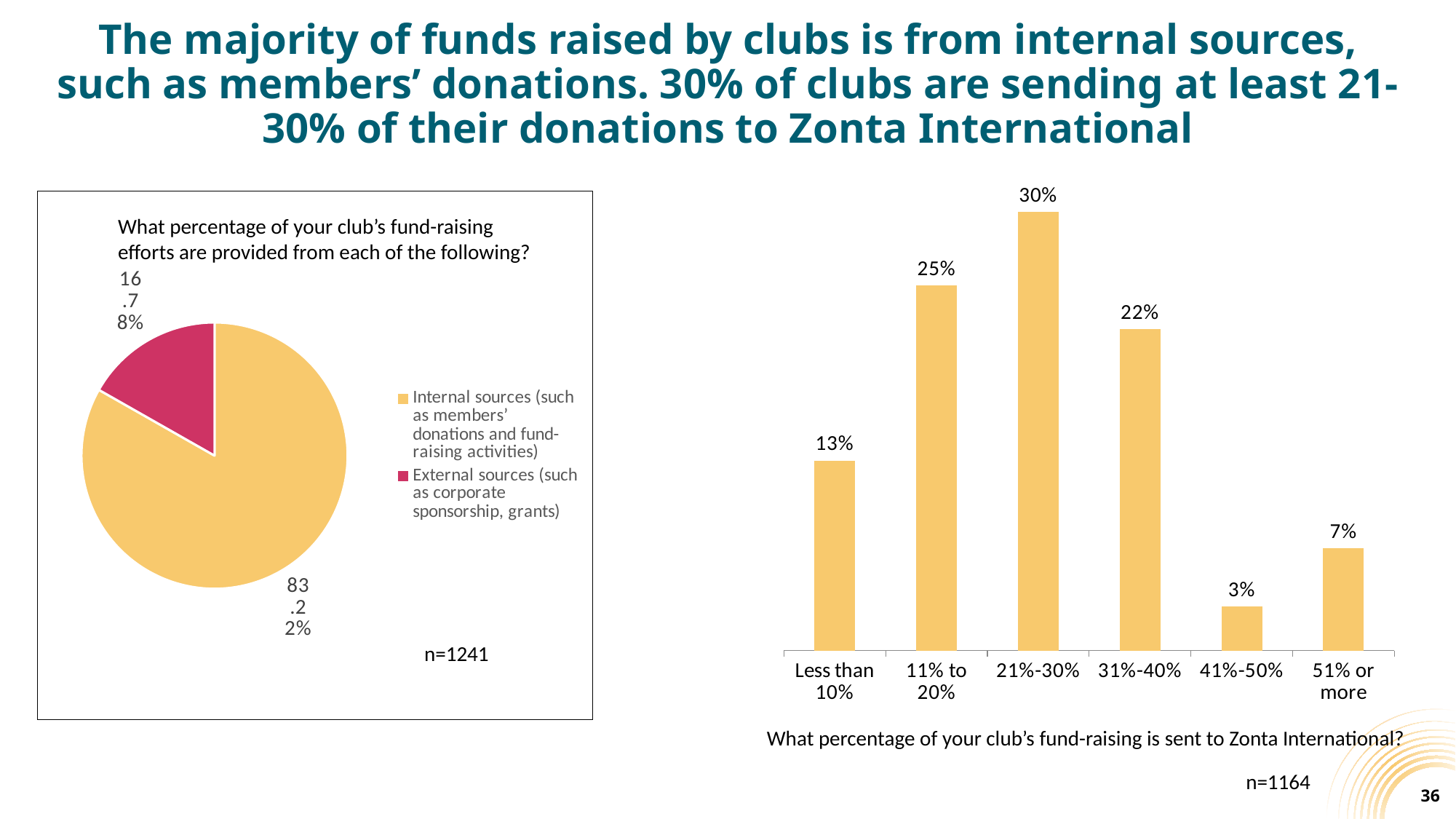
How many entries does the legend of the pie chart on the left list? 2 On the bar chart on the right, what is the difference between the values for '11% to 20%' and '31%-40%'? 3% On the bar chart on the right, which is larger: the value for '51% or more' or the value for '41%-50%'? 51% or more On the bar chart on the right, what is the value for the '41%-50%' category? 3% On the pie chart on the left, what share of fund-raising comes from external sources (such as corporate sponsorship, grants)? 16.78% On the bar chart on the right, which category has the highest value? 21%-30% How many categories are shown on the bar chart on the right? 6 What kind of chart is the chart on the right of the slide? Bar chart On the pie chart on the left, what share of fund-raising comes from internal sources? 83.22% On the bar chart on the right, what is the value for 'Less than 10%'? 13% On the bar chart on the right, which category has the lowest value? 41%-50% On the bar chart on the right, what percentage of clubs send 21%-30% of their fund-raising to Zonta International? 30%